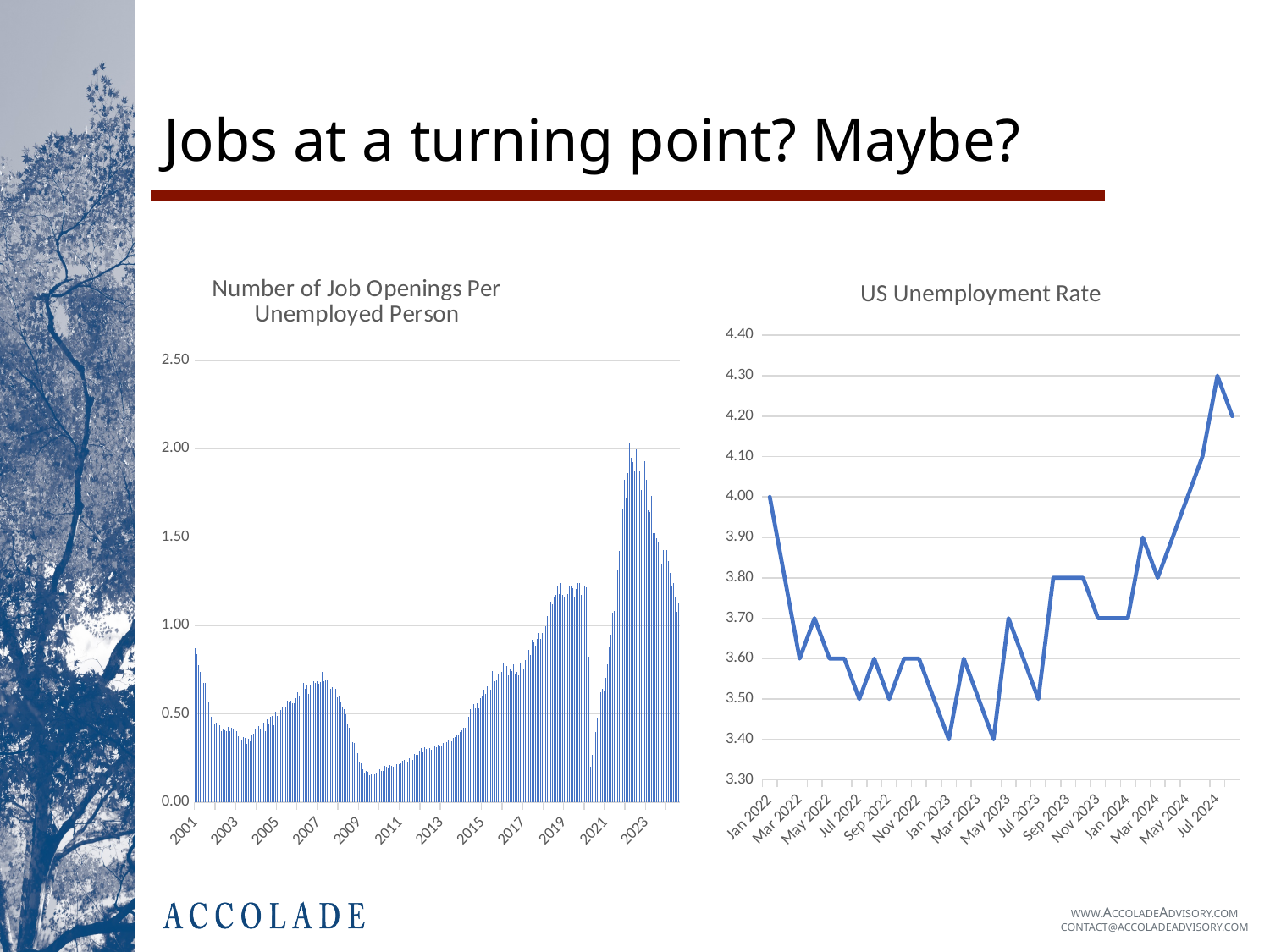
In the "Number of Job Openings Per Unemployed Person" chart, is the peak value around 2022 greater or less than 1.50? greater In the "US Unemployment Rate" chart, which is larger: the unemployment rate in Jan 2022 or in Jan 2023? Jan 2022 In the "US Unemployment Rate" chart, does the unemployment rate rise or fall between Jan 2022 and Jan 2023? fall In the "US Unemployment Rate" chart, what is the lowest unemployment rate shown? 3.40 What type of chart is the "US Unemployment Rate" chart? line chart In the "Number of Job Openings Per Unemployed Person" chart, is the value around 2009 greater or less than 0.50? less What is the title of the chart on the right side of the slide? US Unemployment Rate In the "US Unemployment Rate" chart, is the unemployment rate for Jul 2024 greater or less than 4.00? greater In the "US Unemployment Rate" chart, what is the difference between the highest and lowest unemployment rates shown? 0.90 In the "US Unemployment Rate" chart, what is the unemployment rate for Jan 2022? 4.00 What type of chart is the "Number of Job Openings Per Unemployed Person" chart? bar chart In the "US Unemployment Rate" chart, what is the highest unemployment rate shown? 4.30